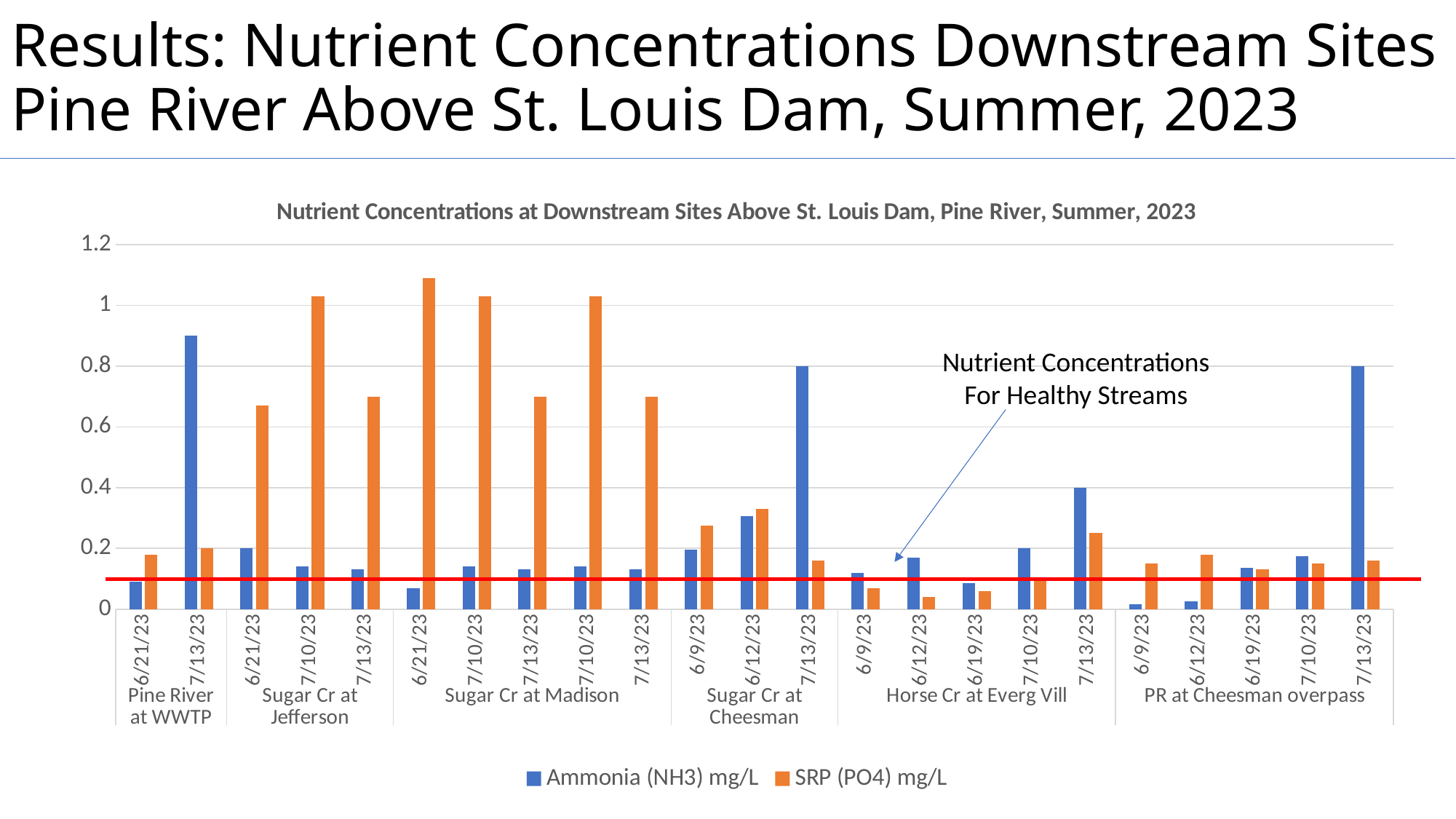
What does the red horizontal line on the chart represent, according to the annotation? Nutrient Concentrations For Healthy Streams Is the Ammonia (NH3) mg/L value for Sugar Cr at Cheesman on 7/13/23 greater or less than 0.6? greater What kind of chart is shown on the slide? Bar chart Is the SRP (PO4) mg/L value for Sugar Cr at Jefferson on 6/21/23 greater or less than 0.8? less What colour are the SRP (PO4) mg/L bars in the chart? Orange For Horse Cr at Everg Vill on 7/13/23, which is larger: Ammonia (NH3) mg/L or SRP (PO4) mg/L? Ammonia (NH3) mg/L Which site and date has the highest Ammonia (NH3) mg/L value? Pine River at WWTP, 7/13/23 Which site and date has the highest SRP (PO4) mg/L value? Sugar Cr at Madison, 6/21/23 How many series does the chart legend list? 2 Is the SRP (PO4) mg/L value for Sugar Cr at Madison on 6/21/23 greater or less than 1? greater How many sampling sites are labelled along the x axis of the chart? 6 For Sugar Cr at Jefferson on 7/10/23, which is larger: Ammonia (NH3) mg/L or SRP (PO4) mg/L? SRP (PO4) mg/L